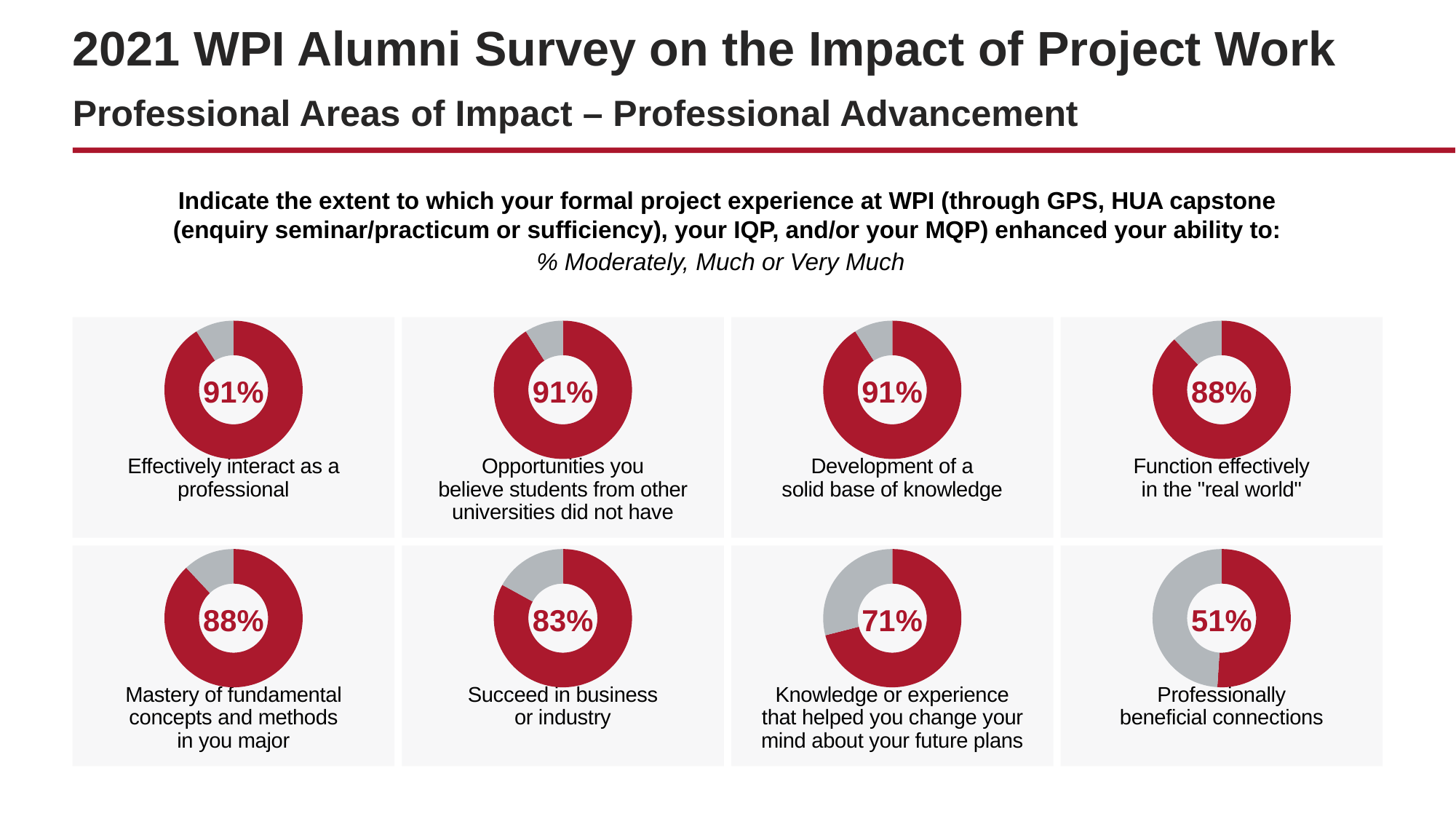
Which item has the lowest percentage on the slide? Professionally beneficial connections How many donut charts are shown on the slide? 8 Which is larger: the percentage for "Succeed in business or industry" or the percentage for "Knowledge or experience that helped you change your mind about your future plans"? Succeed in business or industry What is the difference between the percentage for "Development of a solid base of knowledge" and the percentage for "Professionally beneficial connections"? 40% What is the difference between the percentage for "Mastery of fundamental concepts and methods in you major" and the percentage for "Succeed in business or industry"? 5% What percentage is shown for "Effectively interact as a professional"? 91% What percentage is shown for "Succeed in business or industry"? 83% How many items on the slide show a value of 91%? 3 What kind of chart is used to display each percentage on the slide? Donut chart What percentage is shown for "Knowledge or experience that helped you change your mind about your future plans"? 71% What percentage is shown for "Function effectively in the "real world""? 88% What percentage is shown for "Professionally beneficial connections"? 51%